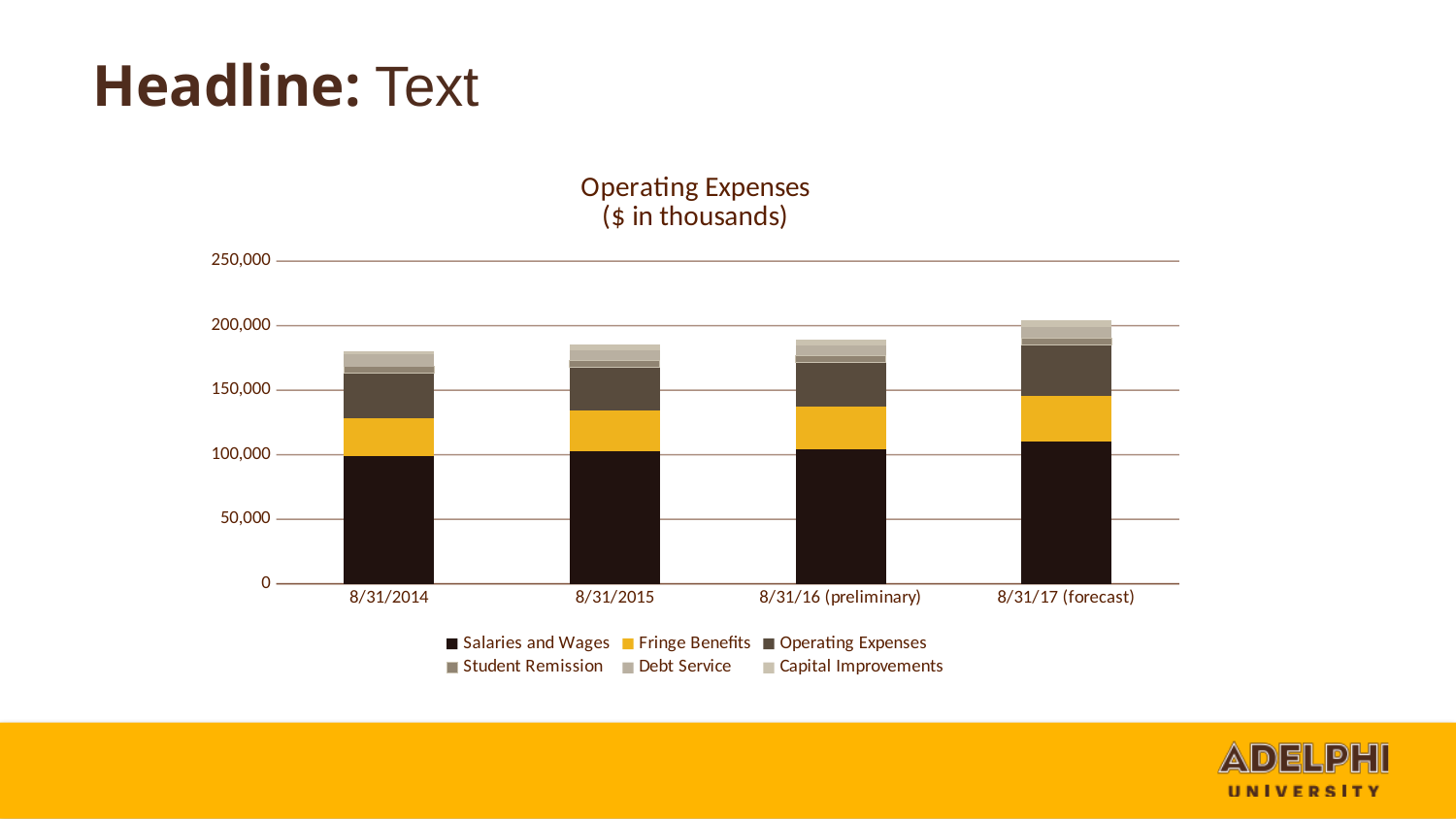
Is the total bar for 8/31/2014 greater or less than 200,000? less What kind of chart is shown on the slide? Stacked bar chart Which series is shown in yellow in the chart? Fringe Benefits How many bars (dates) are shown on the x axis of the chart? 4 What is the title of the chart? Operating Expenses ($ in thousands) Is the Salaries and Wages value for 8/31/17 (forecast) greater or less than 100,000? greater Do total operating expenses rise or fall from 8/31/2014 to 8/31/17 (forecast)? Rise Which date has the highest total operating expenses? 8/31/17 (forecast) Is the total bar for 8/31/2014 greater or less than 150,000? greater Which date has the lowest total operating expenses? 8/31/2014 How many series does the chart's legend list? 6 Which is larger, the total bar for 8/31/2014 or the total bar for 8/31/17 (forecast)? 8/31/17 (forecast)